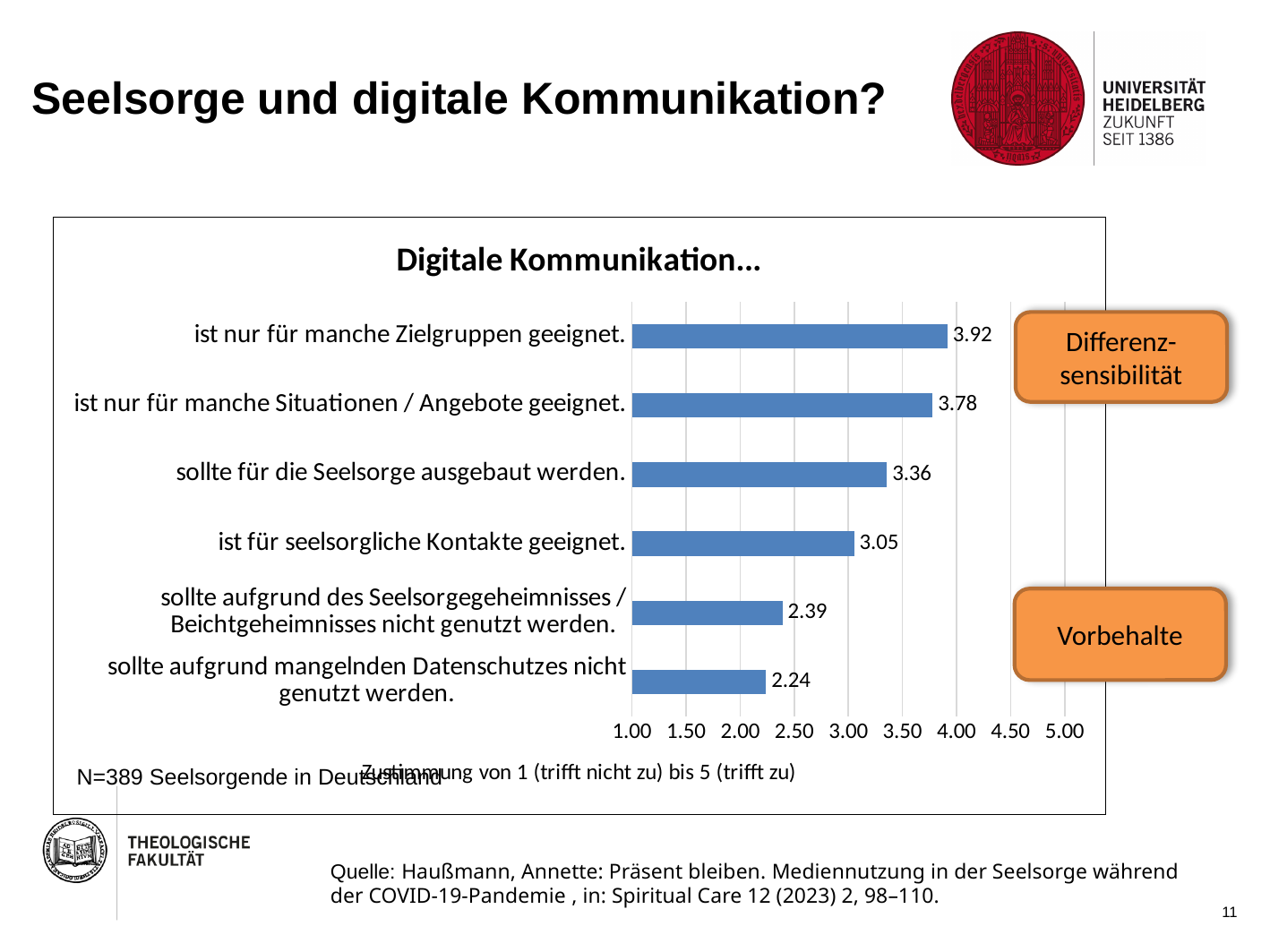
What is the value for "ist nur für manche Zielgruppen geeignet."? 3.92 What is the title of the chart? Digitale Kommunikation... Which category has the lowest value? sollte aufgrund mangelnden Datenschutzes nicht genutzt werden. Which is larger: the value for "sollte aufgrund des Seelsorgegeheimnisses / Beichtgeheimnisses nicht genutzt werden." or the value for "sollte aufgrund mangelnden Datenschutzes nicht genutzt werden."? sollte aufgrund des Seelsorgegeheimnisses / Beichtgeheimnisses nicht genutzt werden. How many categories are shown in the chart? 6 What is the value for "sollte aufgrund mangelnden Datenschutzes nicht genutzt werden."? 2.24 What is the value for "sollte für die Seelsorge ausgebaut werden."? 3.36 What is the difference between the highest and lowest values in the chart? 1.68 What kind of chart is shown on the slide? bar chart Is the value for "ist für seelsorgliche Kontakte geeignet." greater or less than 3.50? less Which category has the highest value? ist nur für manche Zielgruppen geeignet. What is the difference between the values for "ist nur für manche Situationen / Angebote geeignet." and "ist für seelsorgliche Kontakte geeignet."? 0.73